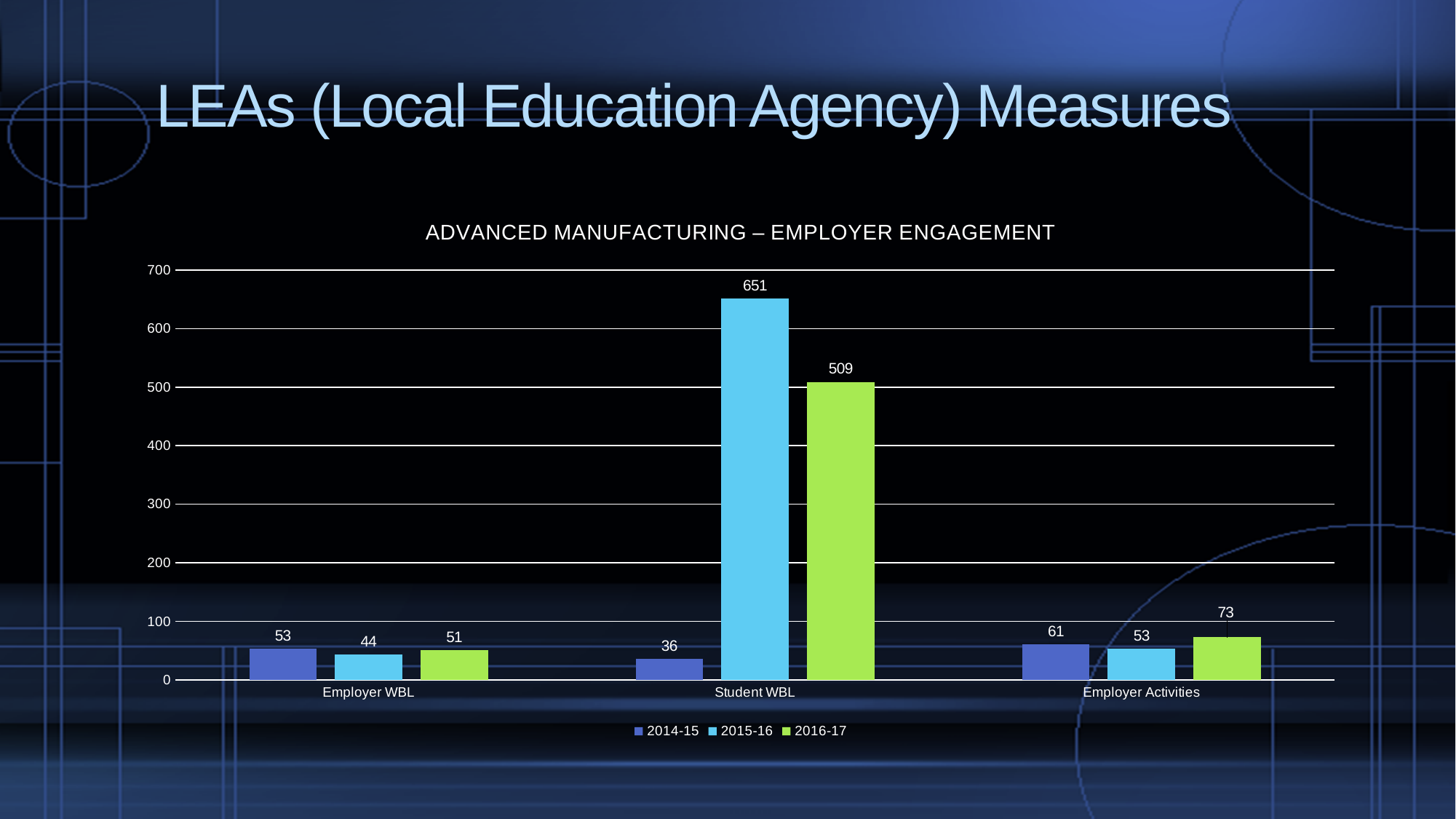
What is the value for Employer WBL in 2014-15? 53 What is the difference between the 2015-16 and 2016-17 values for Student WBL? 142 How many categories are shown on the x axis? 3 What is the value for Student WBL in 2015-16? 651 Is the value for Student WBL in 2016-17 greater or less than 400? greater What kind of chart is shown on the slide? Bar chart Which category has the highest value in the 2015-16 series? Student WBL What is the value for Employer Activities in 2016-17? 73 Which category has the lowest value in the 2014-15 series? Student WBL Which is larger for Employer Activities: the 2014-15 value or the 2015-16 value? 2014-15 How many series does the legend list? 3 What is the title of the chart? ADVANCED MANUFACTURING – EMPLOYER ENGAGEMENT